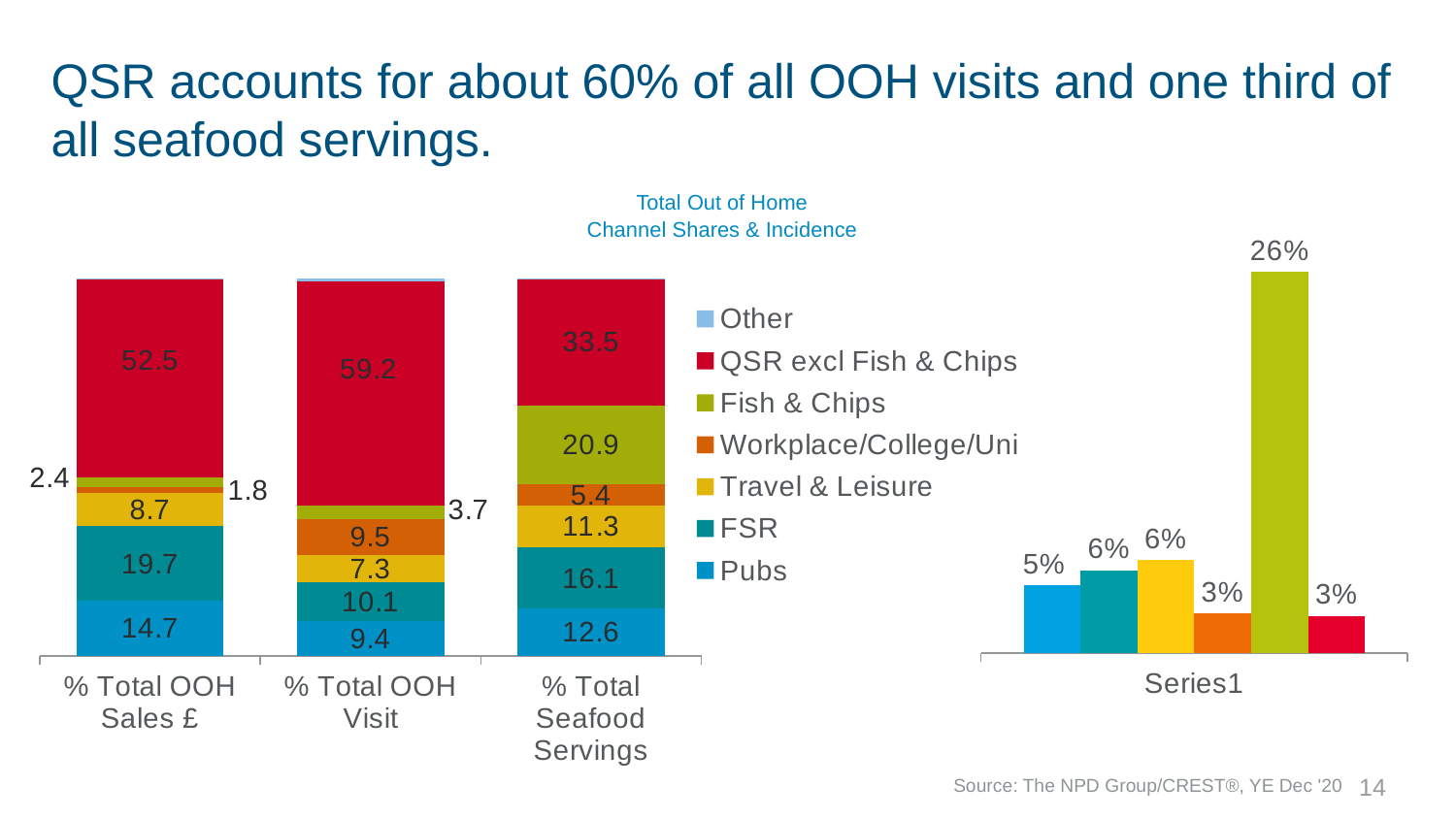
In the 'Total Out of Home Channel Shares & Incidence' chart, what is the value for Pubs in the % Total OOH Sales £ bar? 14.7 In the 'Total Out of Home Channel Shares & Incidence' chart, what is the value for Workplace/College/Uni in the % Total OOH Visit bar? 9.5 In the 'Total Out of Home Channel Shares & Incidence' chart, which channel has the largest segment in the % Total Seafood Servings bar? QSR excl Fish & Chips How many categories are shown on the x axis of the 'Total Out of Home Channel Shares & Incidence' chart? 3 In the chart on the right of the slide labelled Series1, what is the value of the highest bar? 26% How many bars are shown in the chart on the right of the slide labelled Series1? 6 How many series does the legend of the 'Total Out of Home Channel Shares & Incidence' chart list? 7 In the 'Total Out of Home Channel Shares & Incidence' chart, what is the value for QSR excl Fish & Chips in the % Total OOH Visit bar? 59.2 In the 'Total Out of Home Channel Shares & Incidence' chart, what is the value for Fish & Chips in the % Total Seafood Servings bar? 20.9 What kind of chart is the 'Total Out of Home Channel Shares & Incidence' chart? Stacked bar chart In the 'Total Out of Home Channel Shares & Incidence' chart, is the Travel & Leisure value larger for % Total OOH Visit or for % Total Seafood Servings? % Total Seafood Servings In the 'Total Out of Home Channel Shares & Incidence' chart, what is the difference between the FSR value for % Total OOH Sales £ and the FSR value for % Total OOH Visit? 9.6